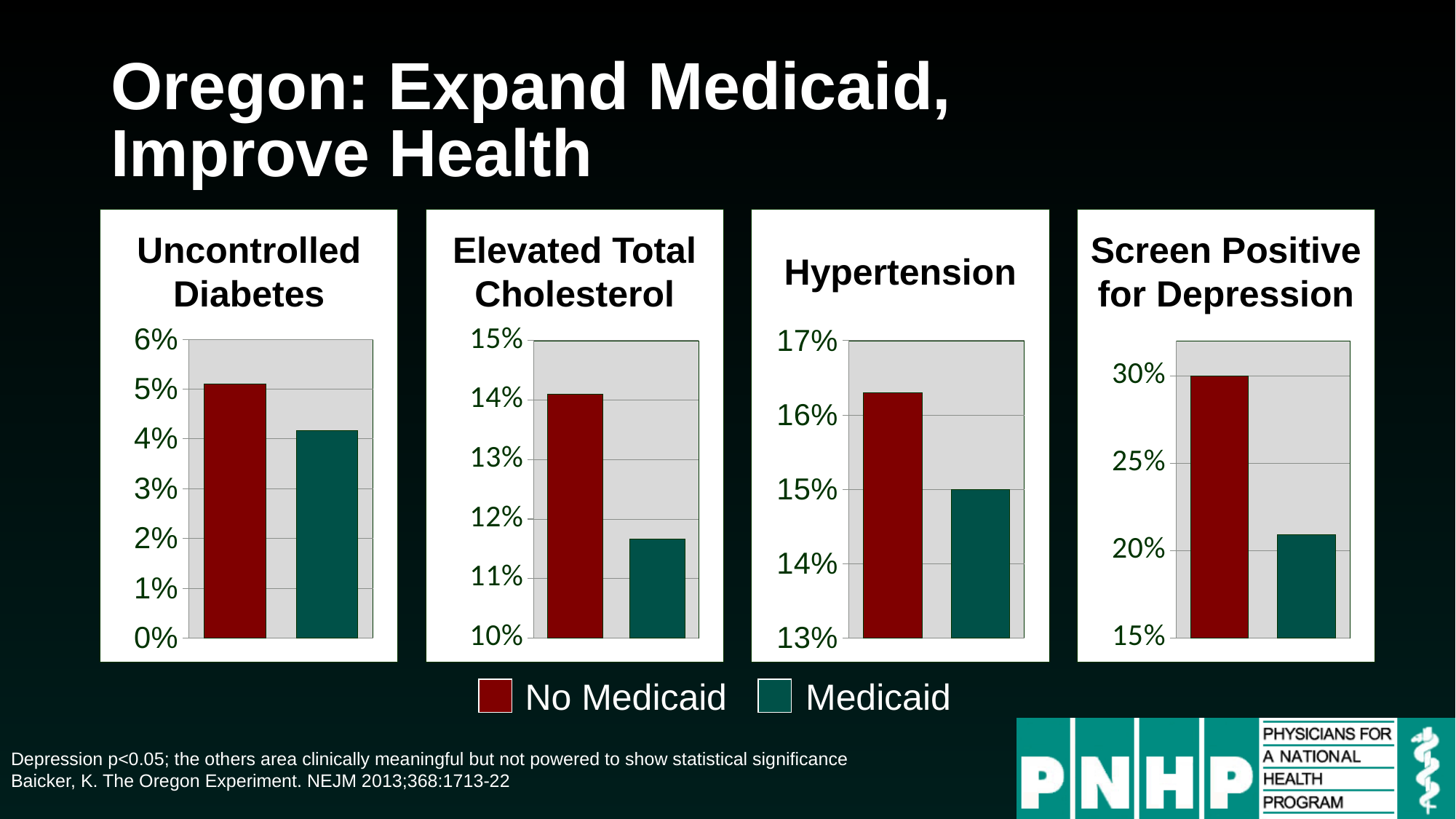
Which colour represents the Medicaid series in the legend? dark green In the Elevated Total Cholesterol chart, is the value for Medicaid greater or less than 12%? less In the Hypertension chart, what is the value for Medicaid? 15% What kind of chart is the Uncontrolled Diabetes chart? bar chart In the Uncontrolled Diabetes chart, is the value for Medicaid greater or less than 5%? less In the Uncontrolled Diabetes chart, which group has the higher value, No Medicaid or Medicaid? No Medicaid In the Screen Positive for Depression chart, is the value for Medicaid greater or less than 25%? less How many series does the legend list? 2 In the Screen Positive for Depression chart, what is the value for No Medicaid? 30%